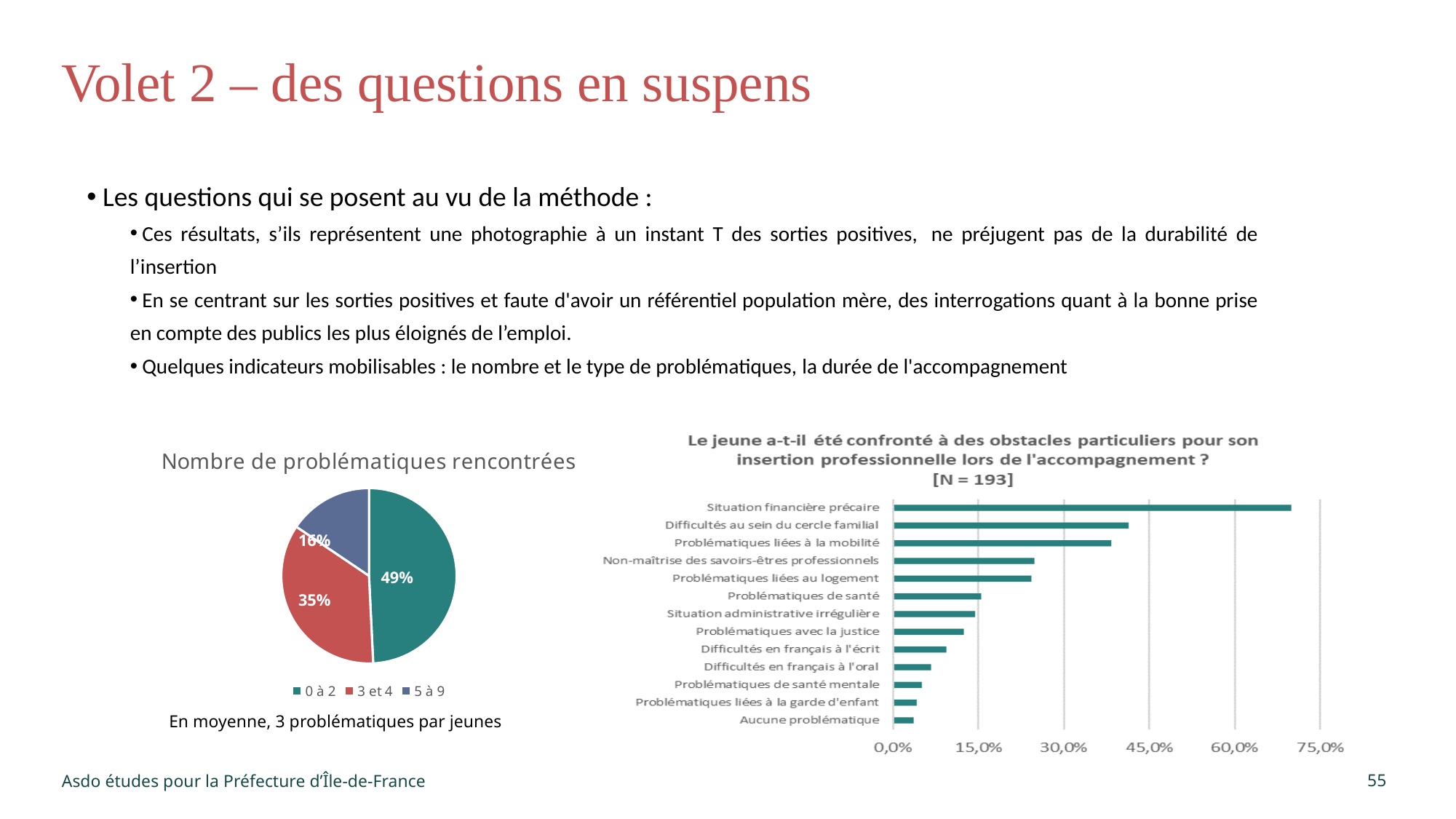
In the pie chart 'Nombre de problématiques rencontrées', which category has the smallest slice? 5 à 9 In the pie chart 'Nombre de problématiques rencontrées', which category has the largest slice? 0 à 2 In the pie chart 'Nombre de problématiques rencontrées', what share is shown for '5 à 9'? 16% In the bar chart on the right, is the value for 'Situation financière précaire' greater or less than 60,0%? greater In the bar chart on the right, which category has the longest bar? Situation financière précaire In the pie chart 'Nombre de problématiques rencontrées', how many categories does the legend list? 3 In the pie chart 'Nombre de problématiques rencontrées', what share is shown for '0 à 2'? 49% What kind of chart is the chart on the right titled 'Le jeune a-t-il été confronté à des obstacles particuliers pour son insertion professionnelle lors de l'accompagnement ?'? bar chart In the bar chart on the right, is the value for 'Problématiques de santé mentale' greater or less than 15,0%? less In the pie chart 'Nombre de problématiques rencontrées', what is the difference in percentage points between '0 à 2' and '3 et 4'? 14 In the pie chart 'Nombre de problématiques rencontrées', what share is shown for '3 et 4'? 35% In the bar chart on the right, how many categories are plotted? 13